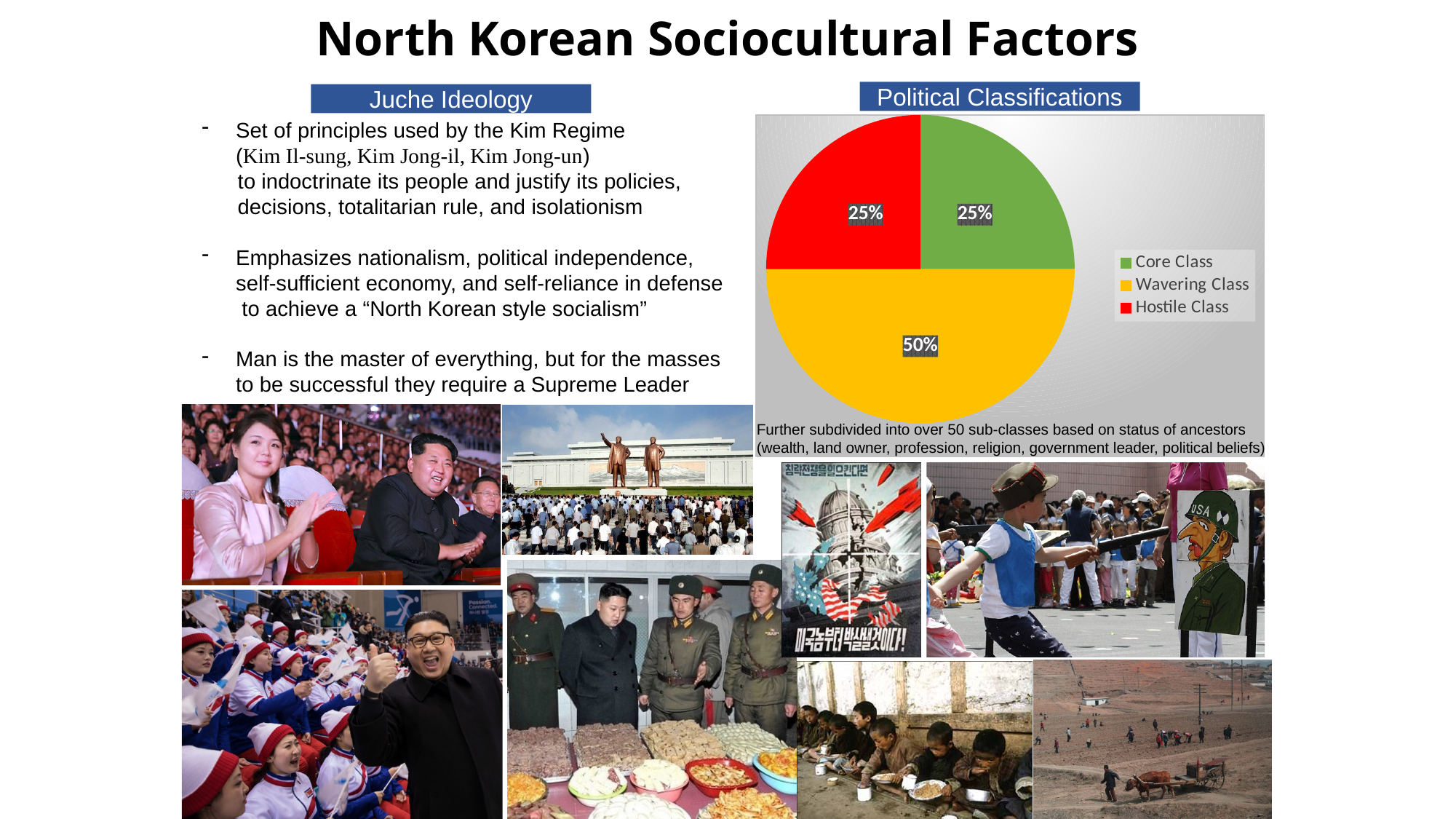
Which is larger, the Wavering Class slice or the Hostile Class slice? Wavering Class What share of the pie does the Core Class represent? 25% What colour represents the Hostile Class in the pie chart? red What colour represents the Core Class in the pie chart? green Which class has the largest slice of the pie chart? Wavering Class How many entries does the pie chart legend list? 3 How many classes are shown in the pie chart? 3 What share of the pie does the Hostile Class represent? 25% What share of the pie does the Wavering Class represent? 50% What kind of chart is shown under the Political Classifications heading? pie chart What is the difference between the Wavering Class share and the Core Class share? 25% What is the combined share of the Core Class and Hostile Class slices? 50%